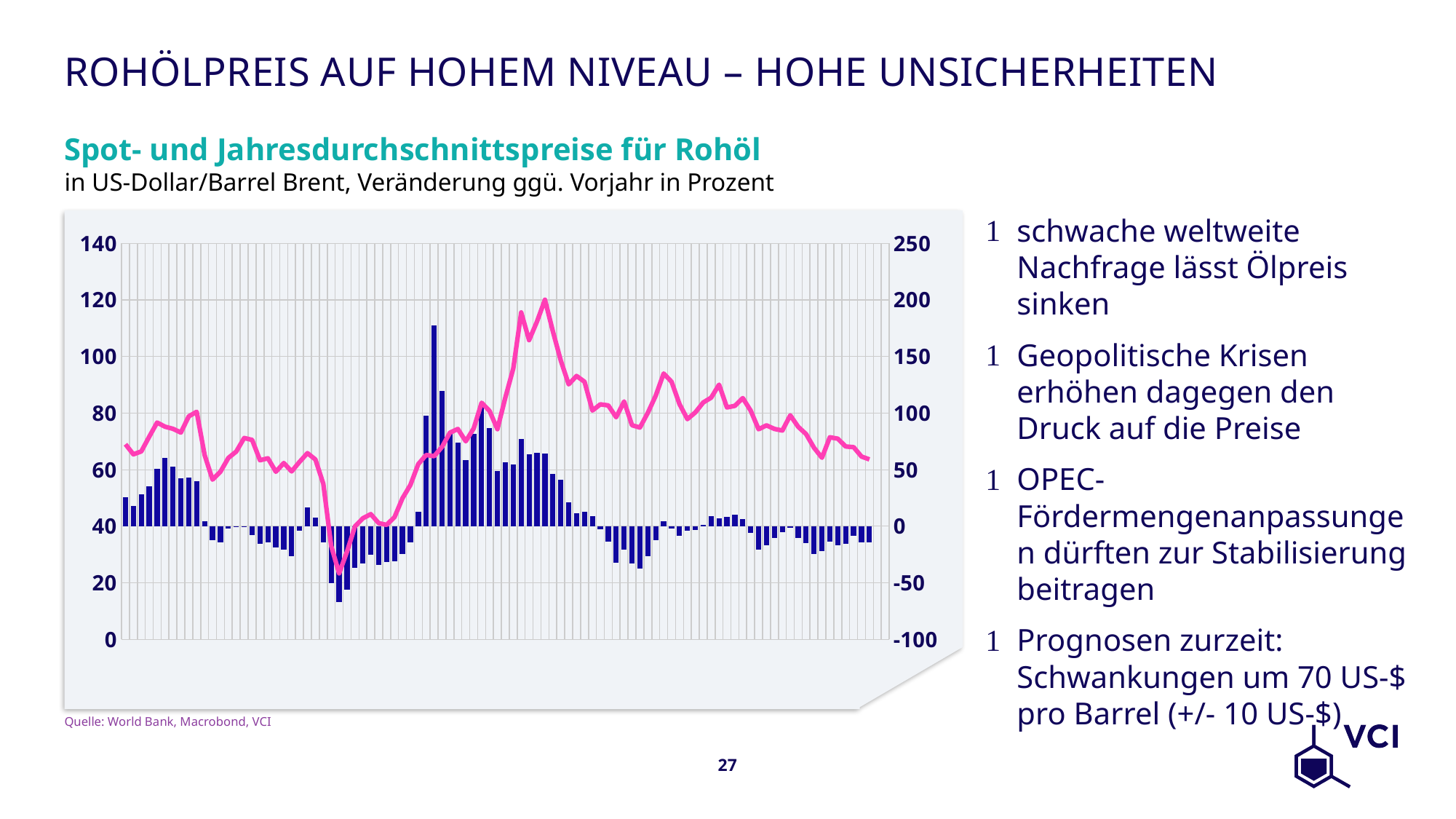
What colour are the bars in the chart? Dark blue Is the peak of the pink line greater or less than 100 on the left axis? greater What kind of chart is shown on the slide? A combined bar and line chart Is the lowest blue bar greater or less than -50 on the right axis? less Is the tallest blue bar greater or less than 150 on the right axis? greater What is the highest tick value shown on the left y-axis? 140 What is the title of the chart? Spot- und Jahresdurchschnittspreise für Rohöl Toward the right end of the chart, does the pink line rise or fall? fall How many data series are plotted in the chart? 2 What is the lowest tick value shown on the right y-axis? -100 What is the highest tick value shown on the right y-axis? 250